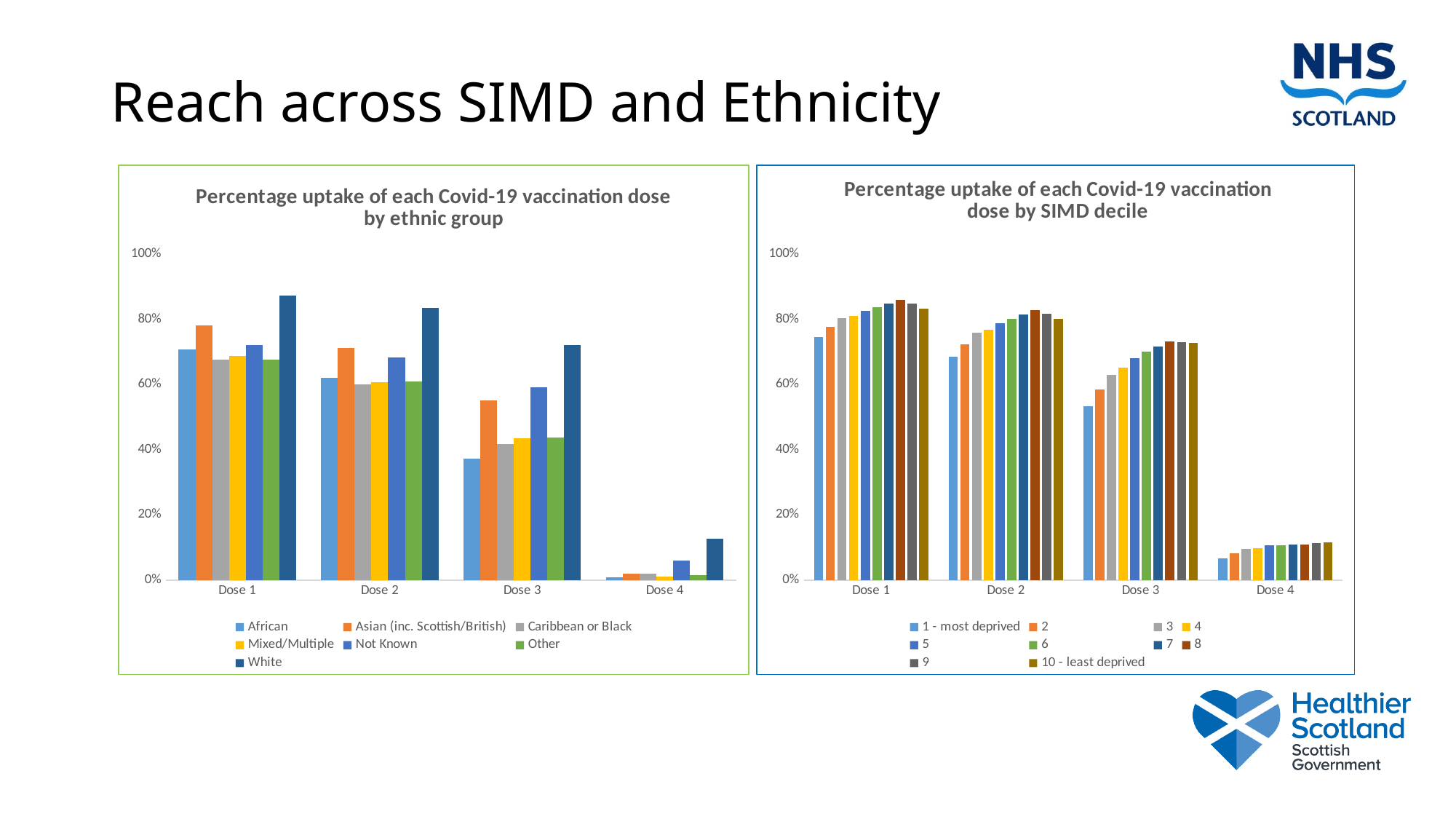
In the right chart (by SIMD decile), is the Dose 1 uptake for '1 - most deprived' greater or less than 80%? less In the left chart (by ethnic group), how many ethnic groups does the legend list? 7 In the left chart (by ethnic group), is the Dose 2 uptake for White greater or less than 80%? greater In the right chart (by SIMD decile), is the Dose 3 uptake for '1 - most deprived' greater or less than 60%? less In the right chart (by SIMD decile), which decile has the lowest uptake for Dose 1? 1 - most deprived In the left chart (by ethnic group), which ethnic group has the highest uptake for Dose 1? White In the left chart (by ethnic group), how many dose categories are shown on the x axis? 4 What kind of chart is the left chart, 'Percentage uptake of each Covid-19 vaccination dose by ethnic group'? bar chart In the right chart (by SIMD decile), which has the larger Dose 3 uptake: '1 - most deprived' or '10 - least deprived'? 10 - least deprived In the right chart (by SIMD decile), how many SIMD deciles does the legend list? 10 In the left chart (by ethnic group), does the uptake for White rise or fall from Dose 1 to Dose 4? fall